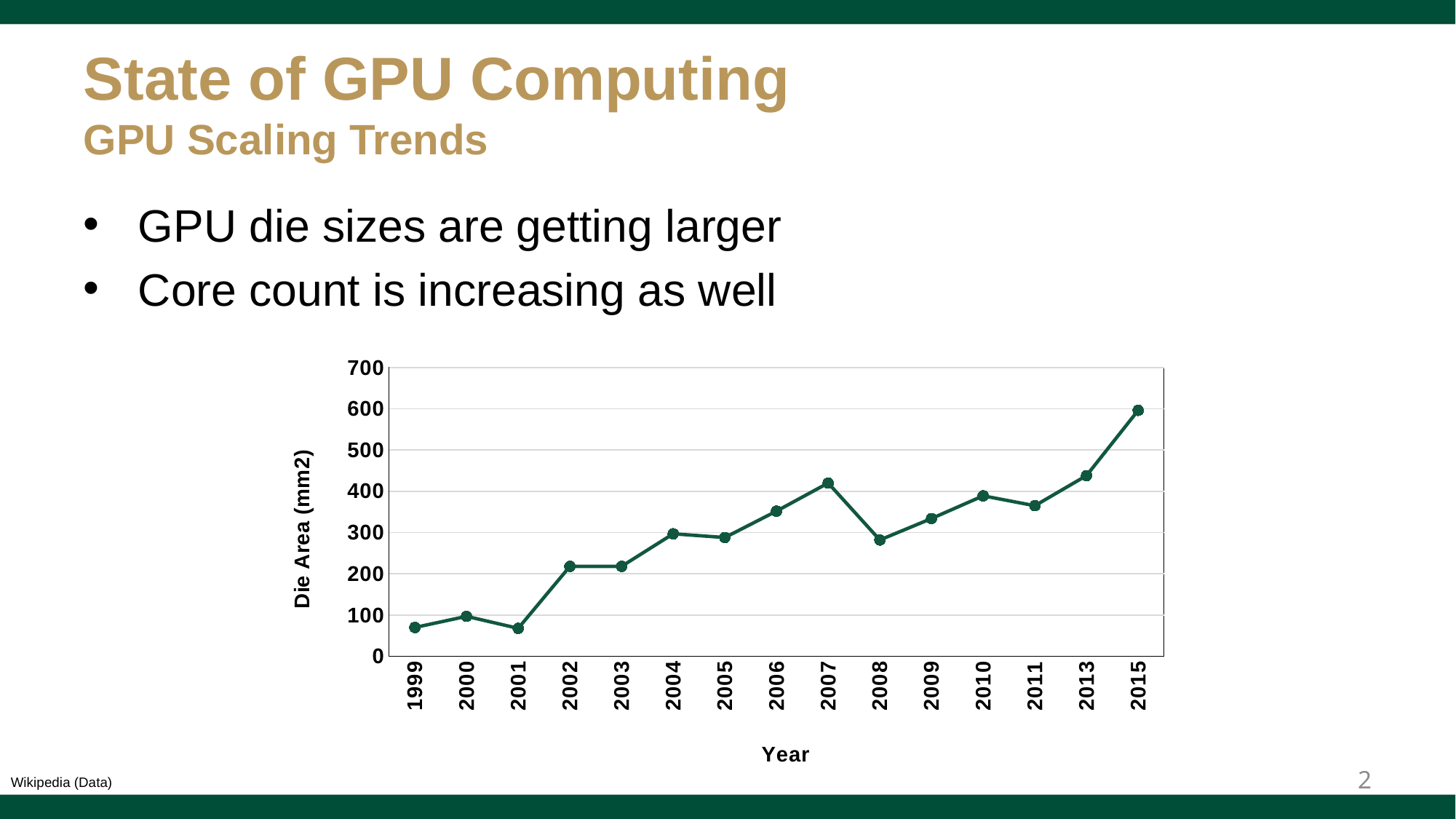
Which year has the highest die area in the chart? 2015 Is the die area for 1999 greater or less than 100? less What is the label of the vertical axis of the chart? Die Area (mm2) Overall, does the die area rise or fall from 1999 to 2015? rise What kind of chart is shown on the slide? line chart Which year has the larger die area, 2010 or 2011? 2010 Is the die area for 2008 greater or less than 300? less Is the die area for 2015 greater or less than 500? greater How many years are plotted on the x axis of the chart? 15 Which year has the larger die area, 2007 or 2008? 2007